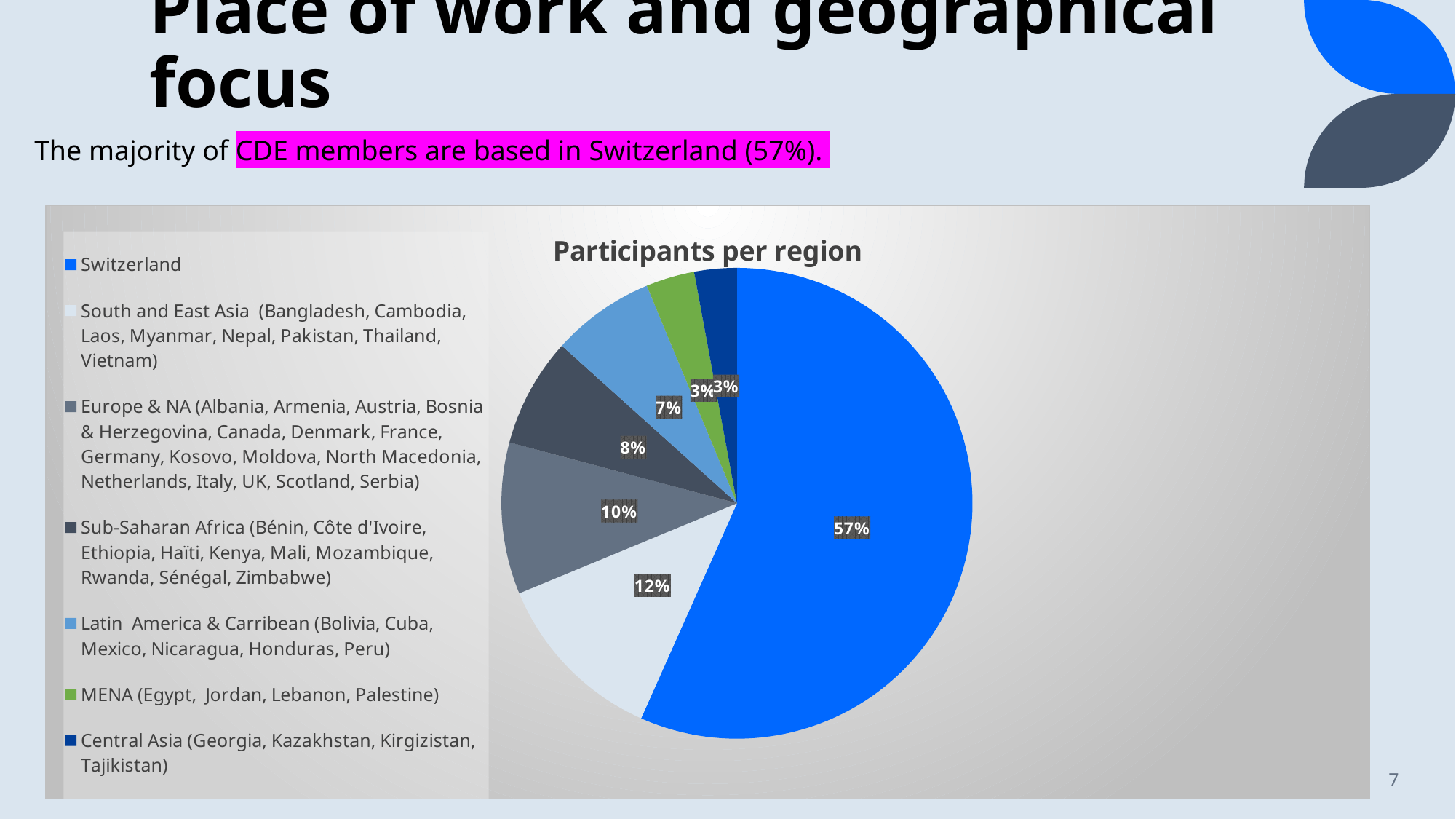
What is the title of the chart? Participants per region Which region has the largest share of participants? Switzerland What share of participants is in Sub-Saharan Africa? 8% What share of participants is in MENA? 3% What share of participants is in Latin America & Carribean? 7% What share of participants is based in Switzerland? 57% How many regions does the legend list? 7 What is the difference in percentage points between Switzerland and South and East Asia? 45 What share of participants is in South and East Asia? 12% What kind of chart is shown on the slide? pie chart Which has a larger share, Europe & NA or Sub-Saharan Africa? Europe & NA What share of participants is in Europe & NA? 10%